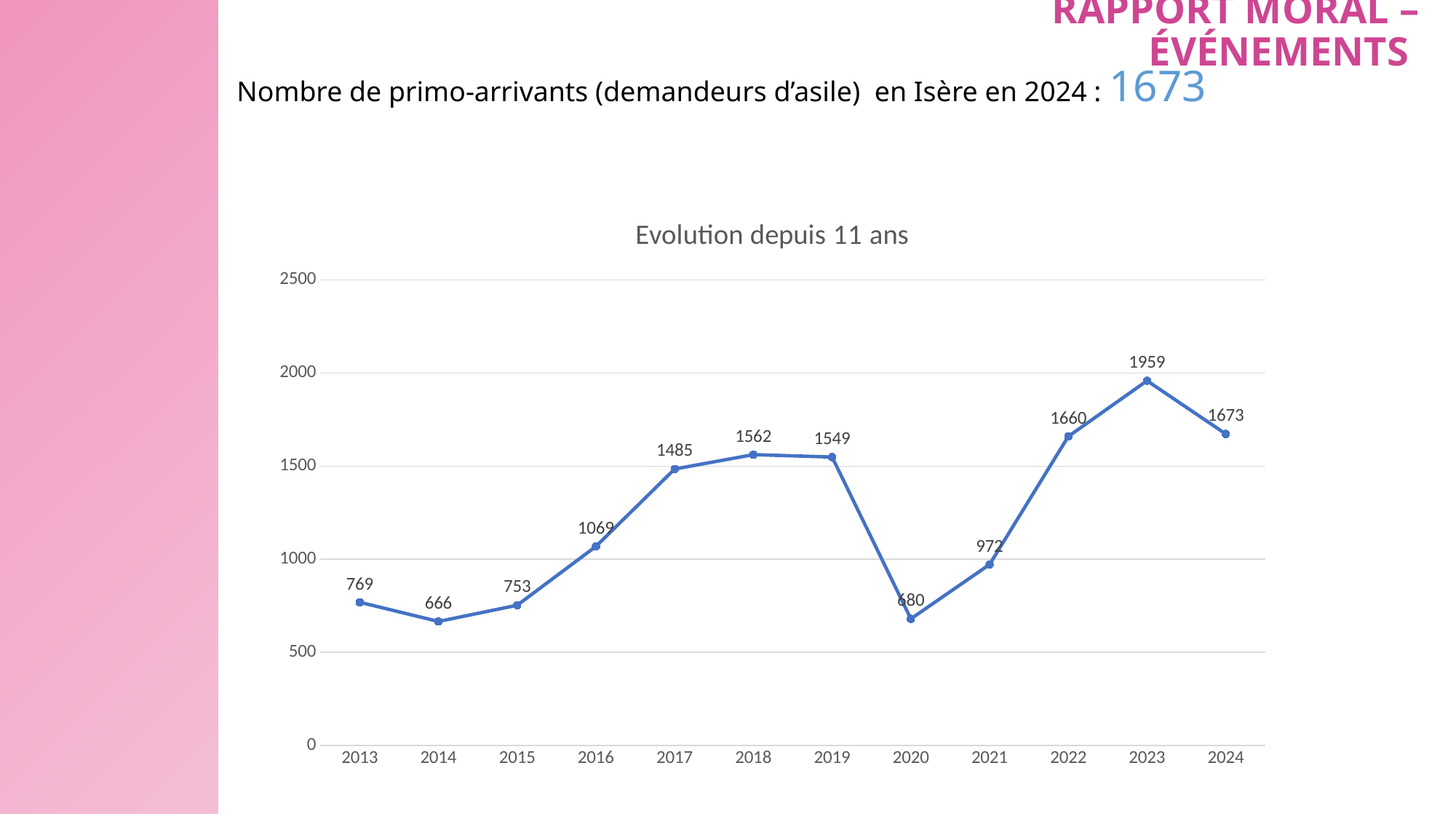
How many years are plotted on the x axis? 12 What is the value for 2017? 1485 Do the values rise or fall from 2020 to 2023? rise Which is larger, the value for 2018 or the value for 2022? 2022 What is the difference between the values for 2023 and 2024? 286 What kind of chart is shown? line chart What is the difference between the values for 2019 and 2020? 869 What is the value for 2020? 680 Is the value for 2016 greater or less than 1000? greater Which year has the highest value? 2023 What is the title of the chart? Evolution depuis 11 ans Which year has the lowest value? 2014